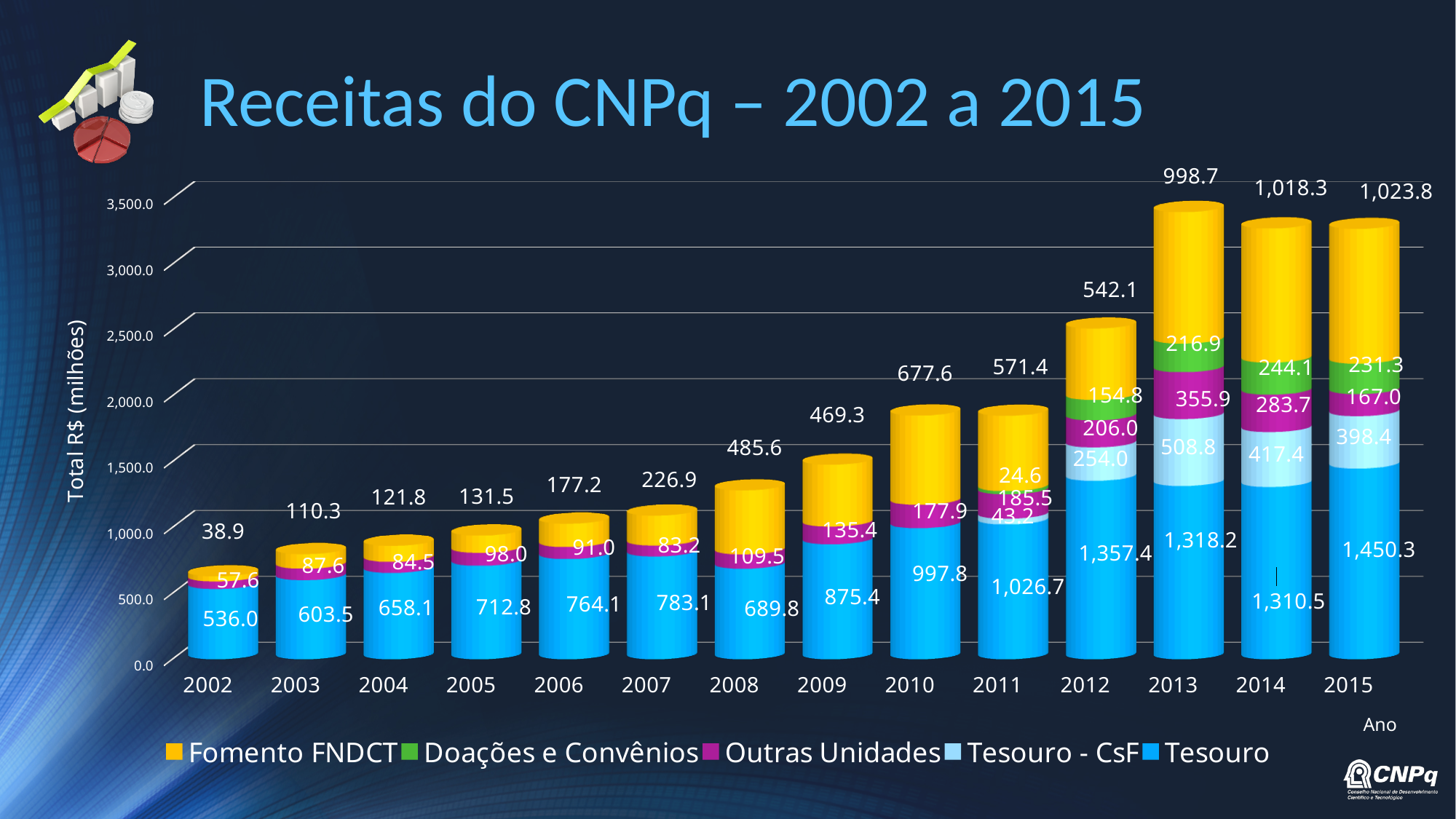
What kind of chart is shown on the slide? Stacked bar chart What is the Doações e Convênios value for 2011? 24.6 What is the total of the stacked bar for 2002? 632.5 Which year has the larger Outras Unidades value, 2013 or 2014? 2013 Which year has the highest Tesouro value? 2015 What is the Fomento FNDCT value for 2013? 998.7 What is the Tesouro value for 2002? 536.0 What is the difference between the Tesouro values for 2015 and 2014? 139.8 Which year has the lowest Fomento FNDCT value? 2002 What is the Tesouro - CsF value for 2014? 417.4 How many years are shown on the x axis? 14 How many series does the legend list? 5